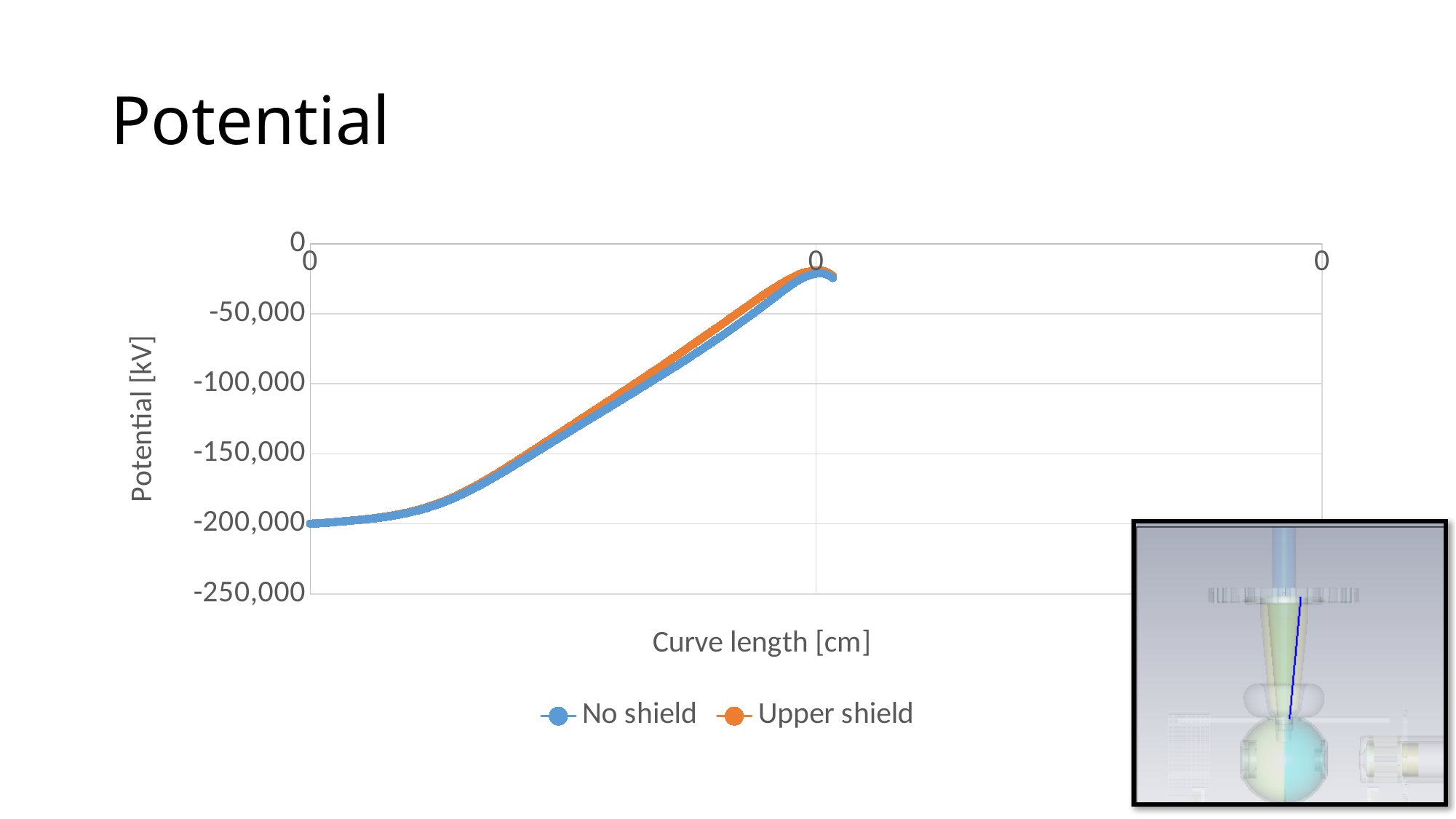
Is the highest value reached by the Upper shield series greater or less than -50,000? greater What is the title of the x axis? Curve length [cm] Is the highest value reached by the No shield series greater or less than -50,000? greater Is the lowest value of the No shield series greater or less than -250,000? greater What kind of chart is shown on the slide? line chart How many series does the legend list? 2 What is the title of the y axis? Potential [kV] What is the lowest value labelled on the y axis? -250,000 Do the plotted values rise or fall as curve length increases along the x axis? rise